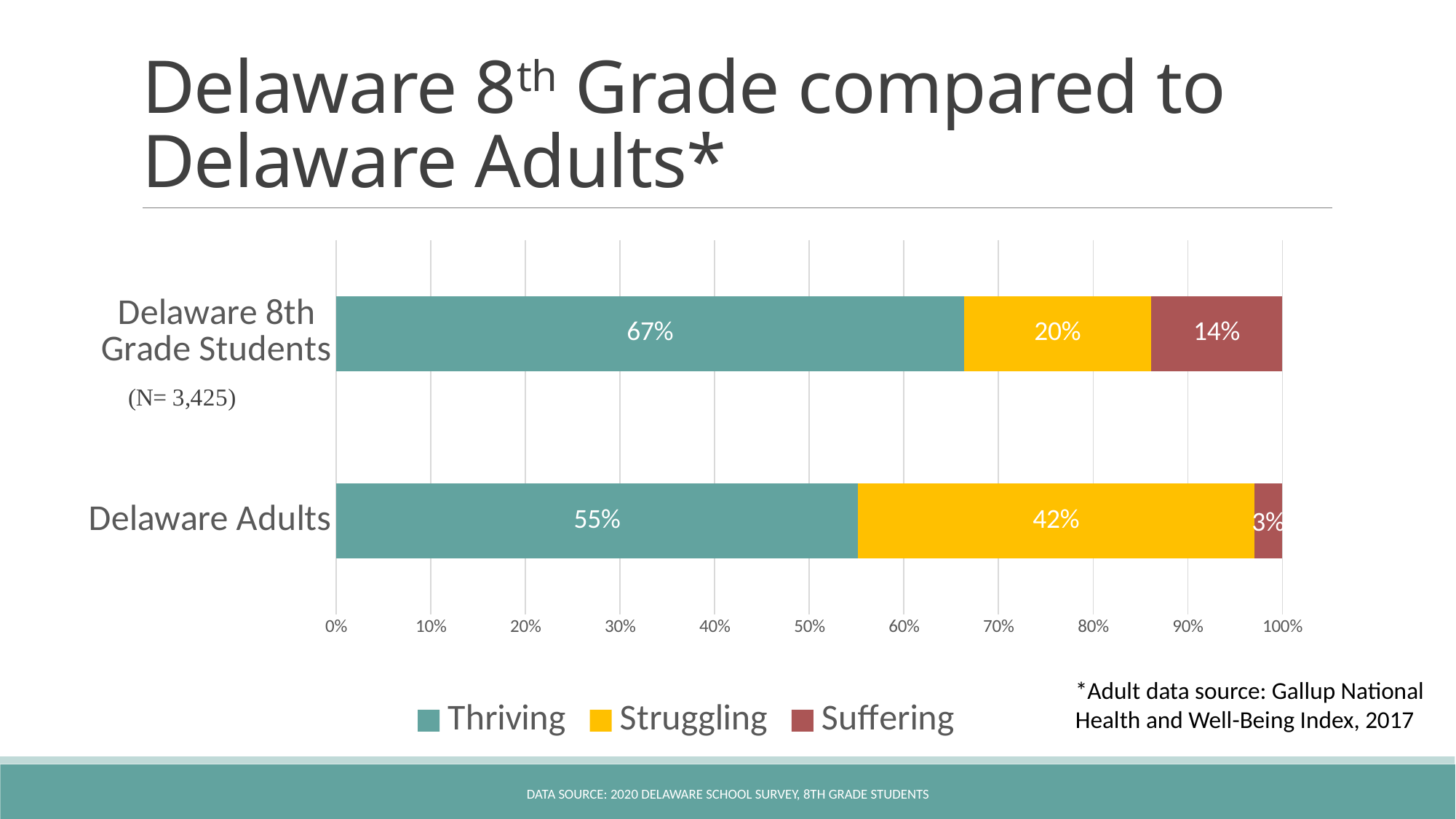
What percentage of Delaware Adults are Suffering? 3% What is the difference in the Struggling percentage between Delaware Adults and Delaware 8th Grade Students? 22 percentage points What percentage of Delaware 8th Grade Students are Struggling? 20% What is the difference in the Thriving percentage between Delaware 8th Grade Students and Delaware Adults? 12 percentage points Which group has the higher Thriving percentage, Delaware 8th Grade Students or Delaware Adults? Delaware 8th Grade Students What percentage of Delaware 8th Grade Students are Thriving? 67% Which colour represents the Struggling series in the chart? Yellow Which group has the higher Suffering percentage? Delaware 8th Grade Students What kind of chart is shown on the slide? Stacked bar chart How many groups (categories) are shown on the chart? 2 What percentage of Delaware Adults are Struggling? 42% How many series does the legend list? 3